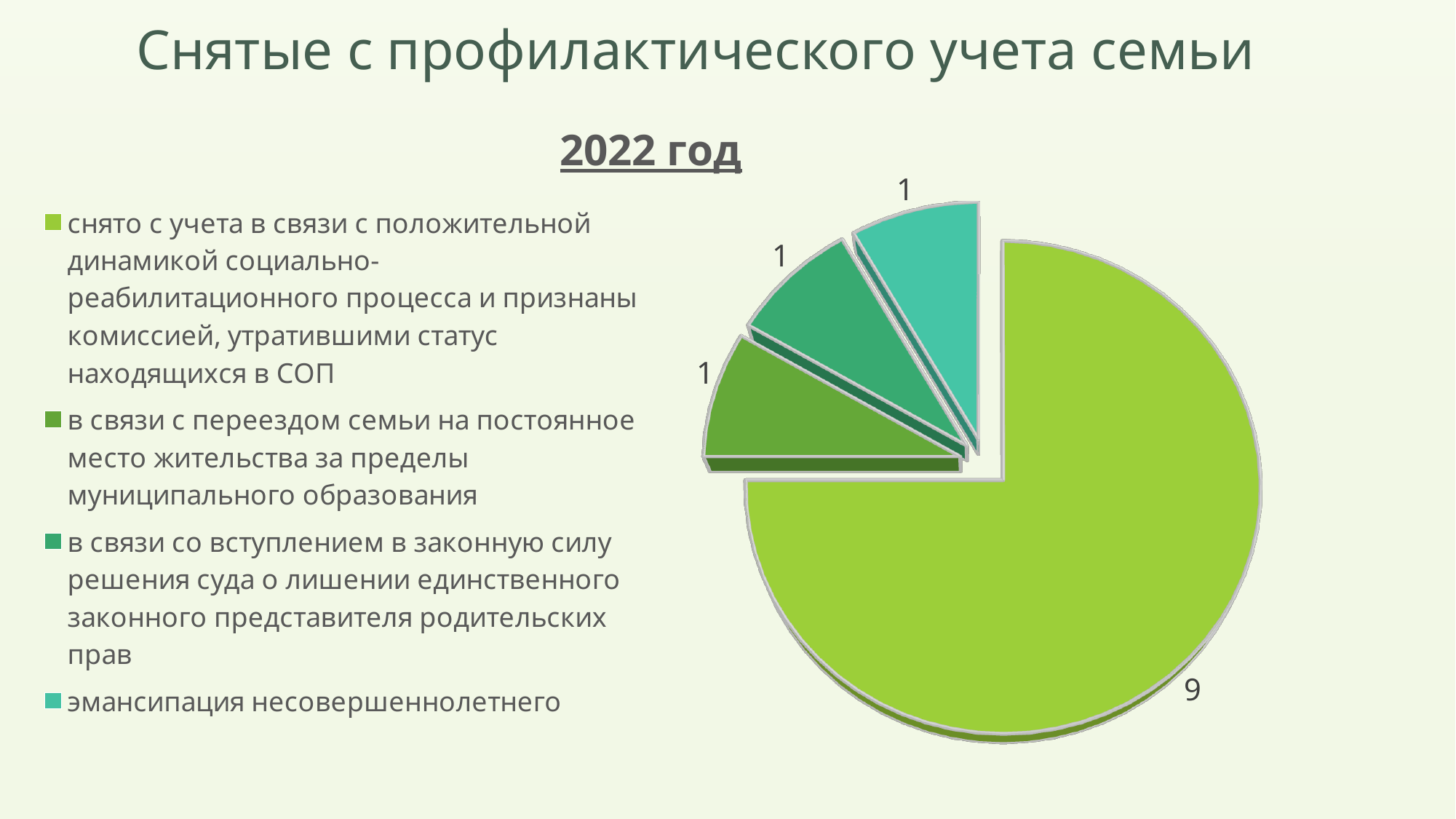
Which category has the largest slice of the pie? снято с учета в связи с положительной динамикой социально-реабилитационного процесса и признаны комиссией, утратившими статус находящихся в СОП Which is larger: the value for 'снято с учета в связи с положительной динамикой...' or the value for 'в связи с переездом семьи...'? снято с учета в связи с положительной динамикой социально-реабилитационного процесса и признаны комиссией, утратившими статус находящихся в СОП What kind of chart is shown on the slide? pie chart What is the value for the slice 'снято с учета в связи с положительной динамикой социально-реабилитационного процесса и признаны комиссией, утратившими статус находящихся в СОП'? 9 What is the total of all slice values in the pie chart? 12 How many entries does the legend list? 4 What is the difference between the largest slice value and the value for 'эмансипация несовершеннолетнего'? 8 What is the value for the slice 'в связи с переездом семьи на постоянное место жительства за пределы муниципального образования'? 1 What is the value for the slice 'эмансипация несовершеннолетнего'? 1 Which year does the chart refer to, according to the subtitle? 2022 год What share of the pie does the slice with value 9 represent? 75% How many slices does the pie chart have? 4